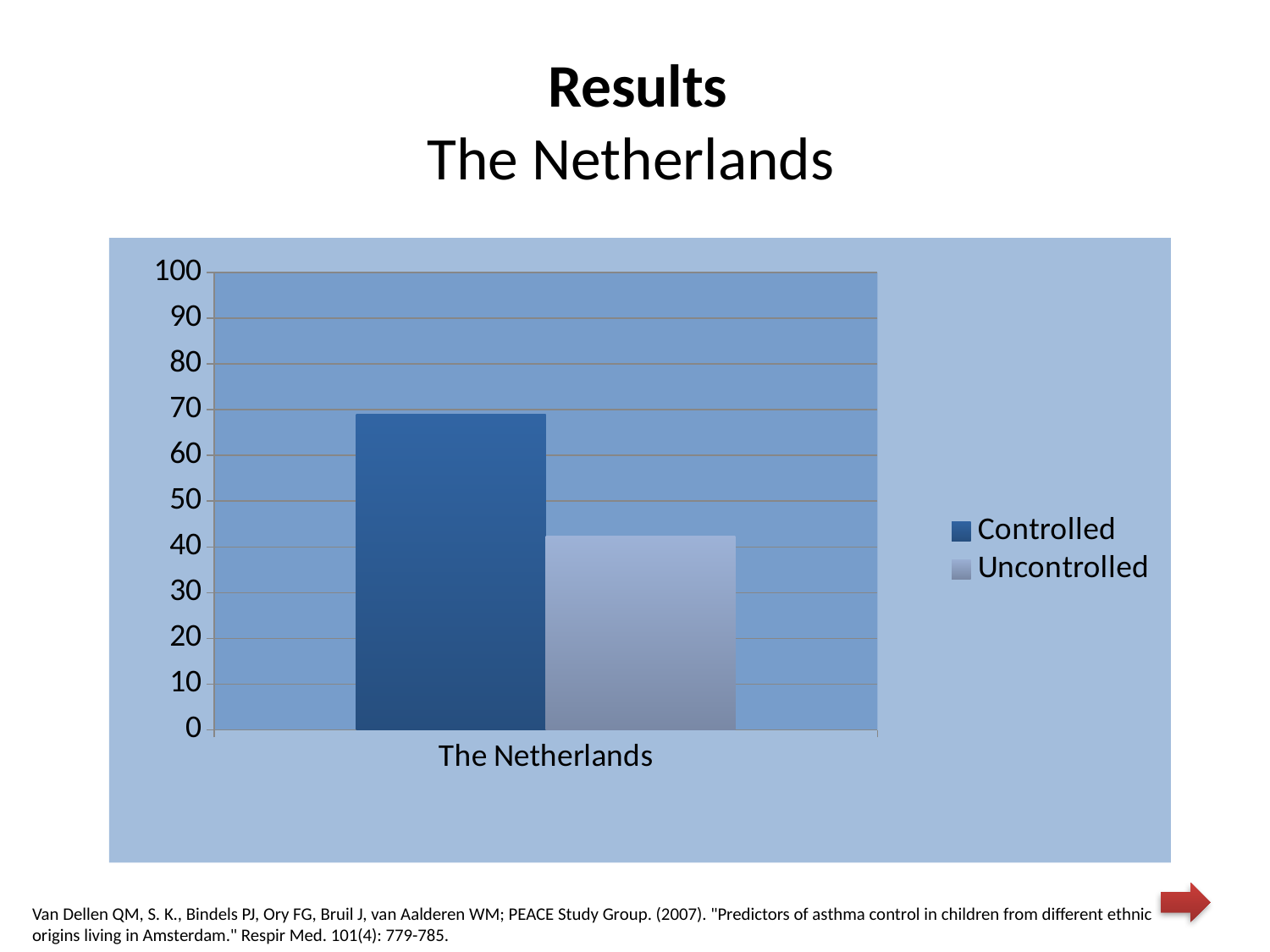
Is the value for Uncontrolled greater or less than 50? less How many series does the legend list? 2 Which series has the lower bar for The Netherlands? Uncontrolled Is the value for Uncontrolled greater or less than 30? greater Is the value for Controlled greater or less than 80? less What is the category label on the x axis? The Netherlands How many categories are shown on the x axis? 1 What are the two series named in the legend? Controlled and Uncontrolled Is the Controlled bar larger or smaller than the Uncontrolled bar? larger What kind of chart is shown on the slide? bar chart Which series has the higher bar for The Netherlands? Controlled